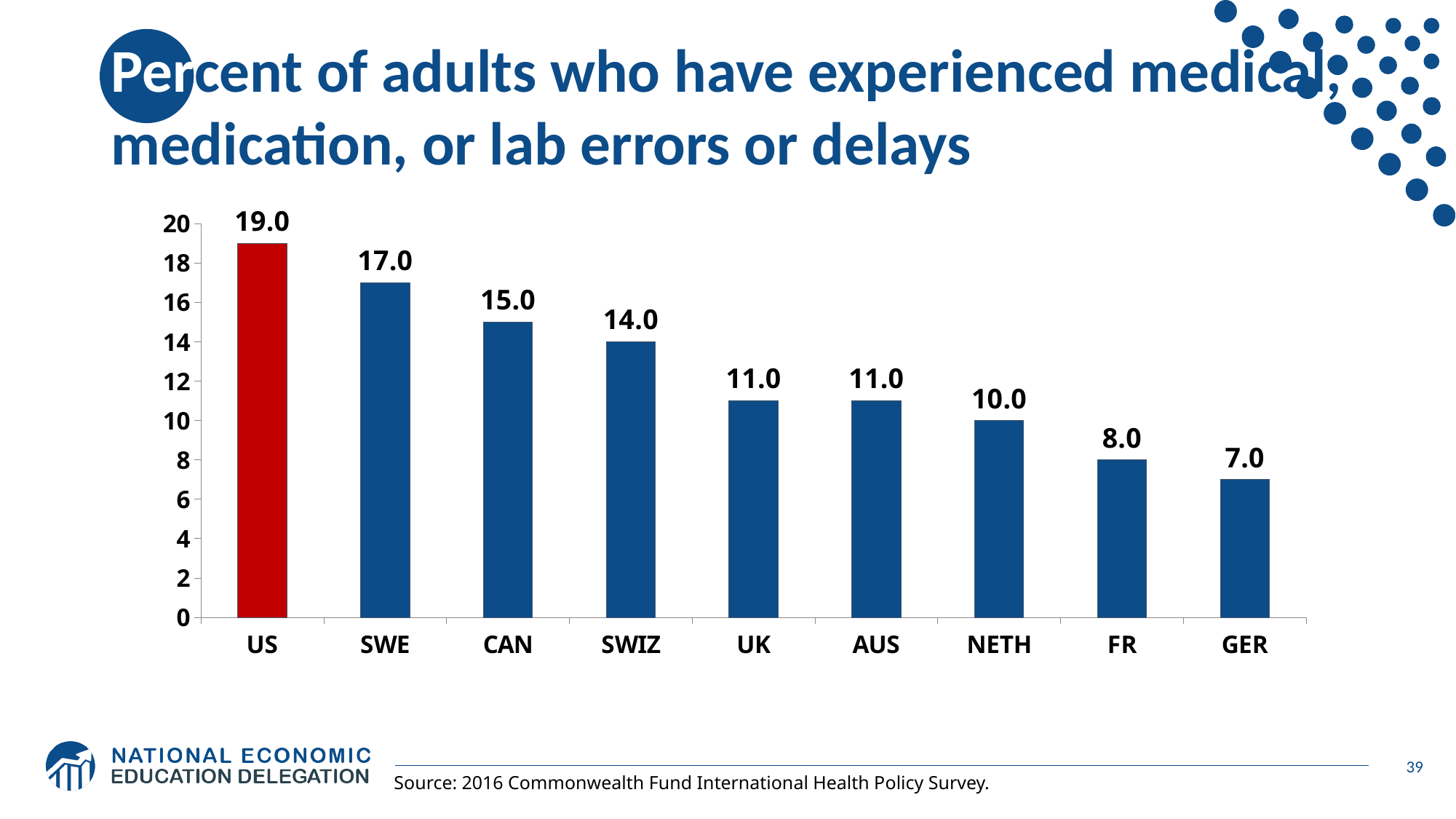
What kind of chart is shown on the slide? bar chart Which is larger, the value for FR or the value for NETH? NETH Which bar is coloured red rather than blue? US What is the value for NETH? 10.0 Is the value for CAN greater or less than 10? greater What is the value for SWIZ? 14.0 What is the difference between the values for SWE and CAN? 2.0 What is the difference between the values for the US and GER? 12.0 How many countries are shown in the chart? 9 Which country has the lowest value? GER What is the value for the US? 19.0 Which country has the highest value? US